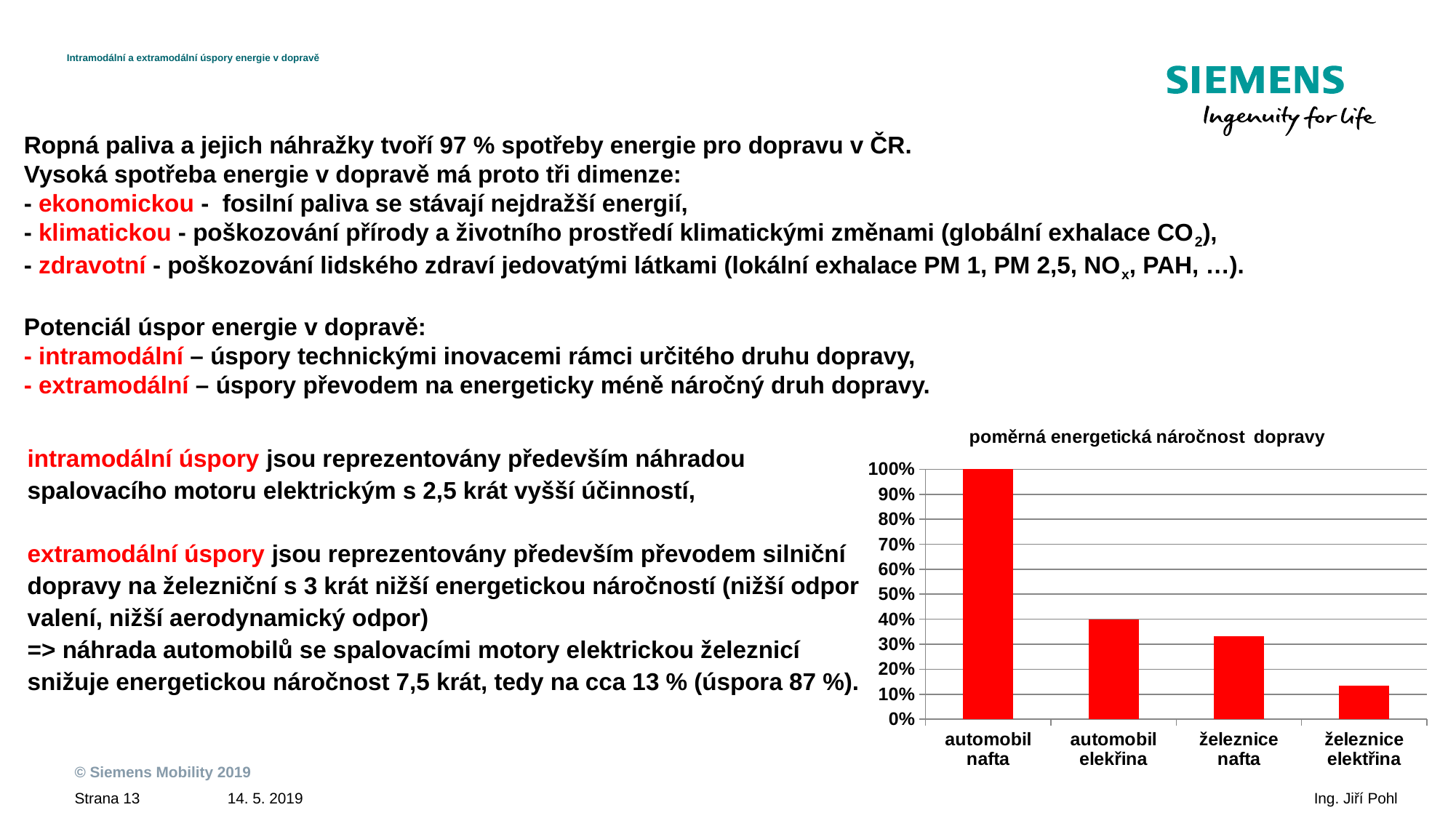
Which category has the lowest value in the chart? železnice elektřina How many categories are plotted in the chart? 4 Is the value for železnice nafta greater or less than 30%? greater What kind of chart is shown on the slide? bar chart Which is larger, the value for automobil elekřina or the value for železnice nafta? automobil elekřina Is the value for železnice elektřina greater or less than 20%? less What is the value for automobil nafta? 100% What colour are the bars in the chart? red What is the title of the chart? poměrná energetická náročnost dopravy Do the values rise or fall from left to right along the x axis? fall Which category has the highest value in the chart? automobil nafta Is the value for automobil elekřina greater or less than 50%? less